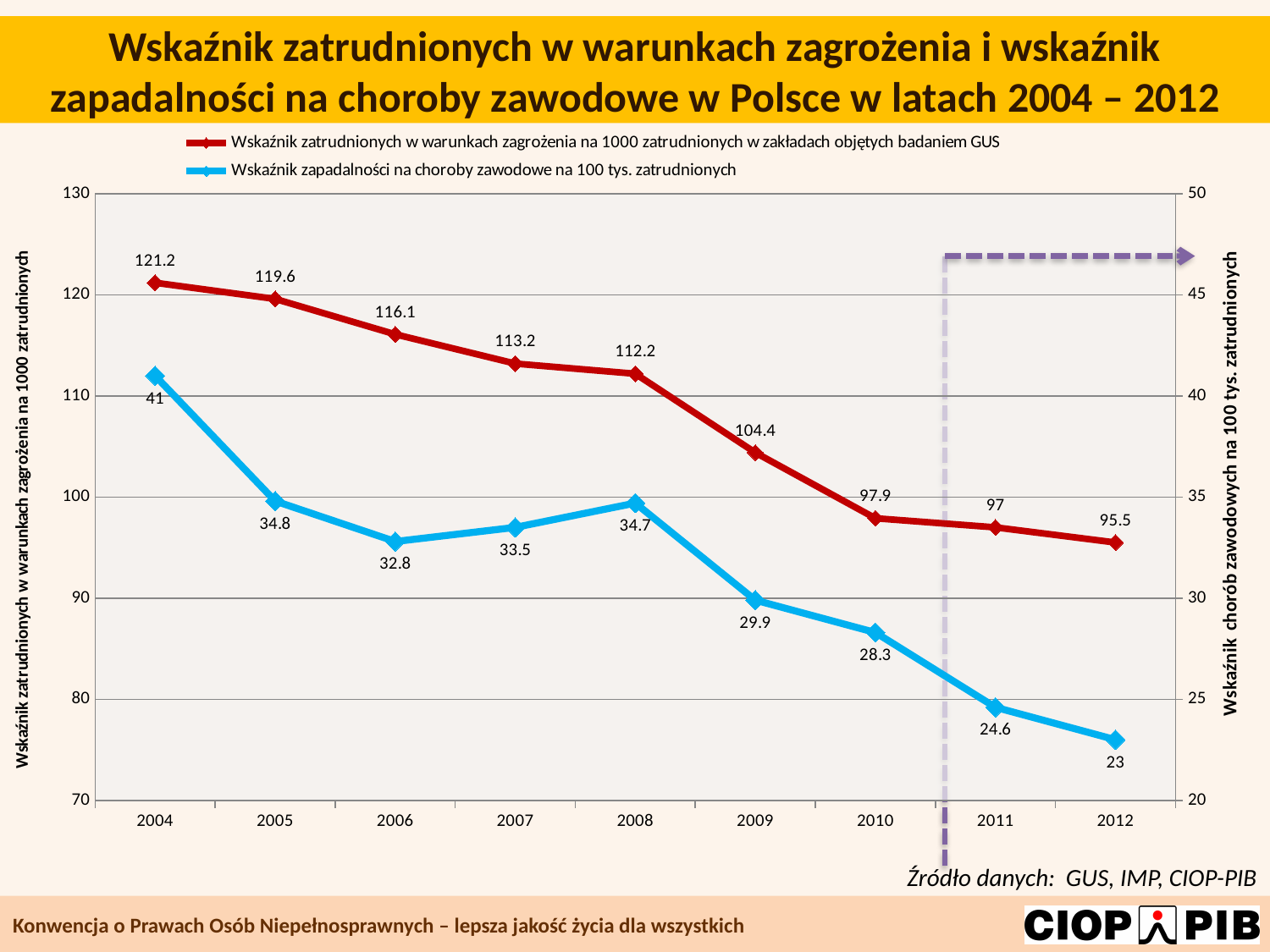
How many series does the chart's legend list? 2 What is the value of the 'Wskaźnik zatrudnionych w warunkach zagrożenia' series for 2011? 97 What is the value of the 'Wskaźnik zatrudnionych w warunkach zagrożenia' series for 2004? 121.2 Which year has the larger value for the 'Wskaźnik zapadalności na choroby zawodowe' series, 2006 or 2008? 2008 How many years are plotted on the x axis of the chart? 9 What is the difference between the 'Wskaźnik zatrudnionych w warunkach zagrożenia' values for 2004 and 2012? 25.7 Does the 'Wskaźnik zatrudnionych w warunkach zagrożenia' series rise or fall from 2004 to 2012? Fall In which year is the 'Wskaźnik zapadalności na choroby zawodowe' series at its highest? 2004 What kind of chart is shown on the slide? Line chart What is the value of the 'Wskaźnik zapadalności na choroby zawodowe' series for 2008? 34.7 What is the value of the 'Wskaźnik zapadalności na choroby zawodowe' series for 2012? 23 In which year is the 'Wskaźnik zatrudnionych w warunkach zagrożenia' series at its lowest? 2012